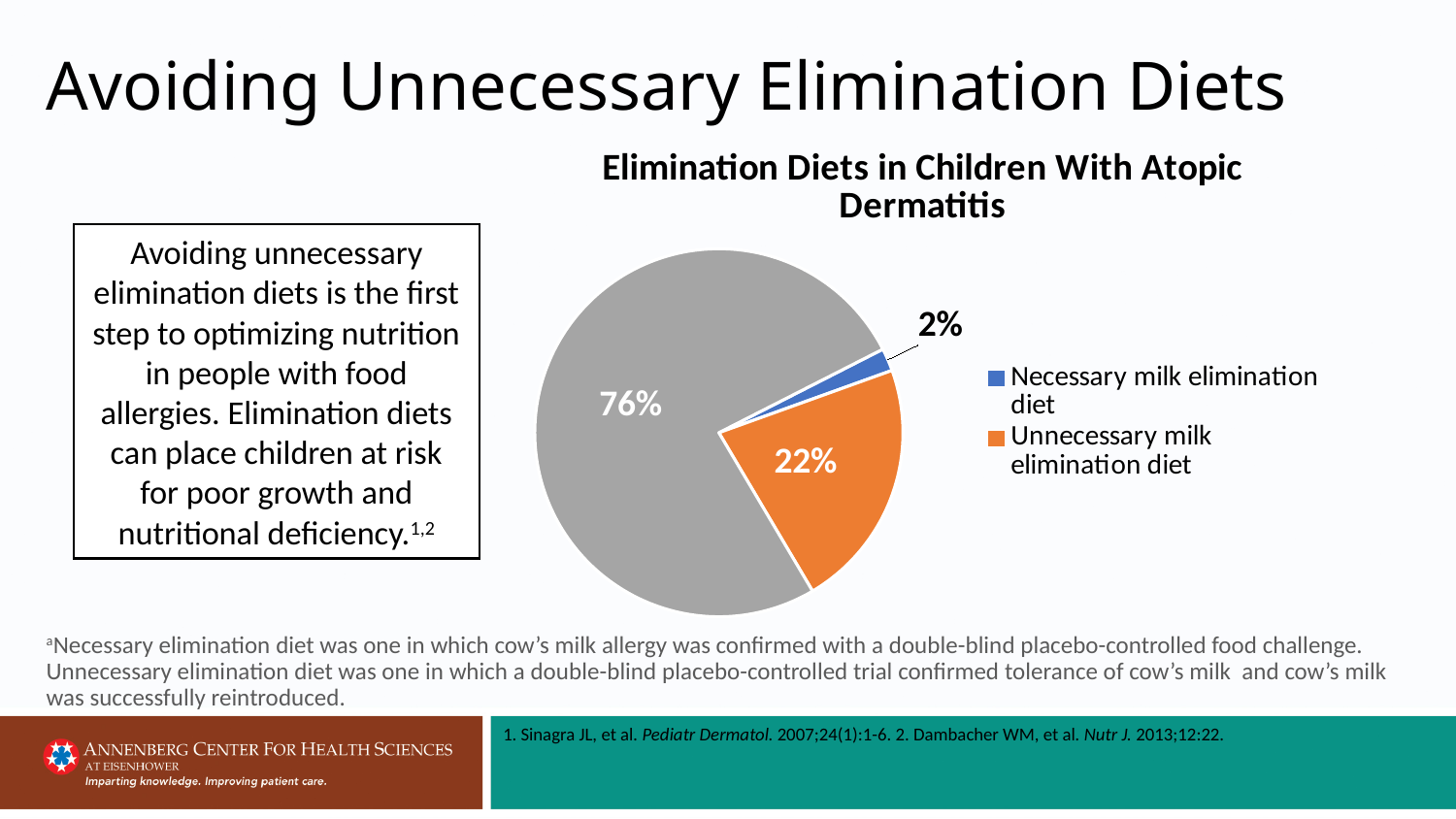
What colour is the Unnecessary milk elimination diet slice? orange What is the value shown on the largest slice of the pie? 76% Which is larger: the Unnecessary milk elimination diet slice or the Necessary milk elimination diet slice? Unnecessary milk elimination diet How many slices does the pie chart have? 3 What is the combined share of the two slices named in the legend? 24% What type of chart is shown on the slide? pie chart What percentage of the pie is labelled as Unnecessary milk elimination diet? 22% What is the chart's title? Elimination Diets in Children With Atopic Dermatitis What is the difference in percentage points between the Unnecessary milk elimination diet slice and the Necessary milk elimination diet slice? 20 What percentage of the pie is labelled as Necessary milk elimination diet? 2% How many entries does the legend list? 2 Which legend entry corresponds to the smallest slice of the pie? Necessary milk elimination diet